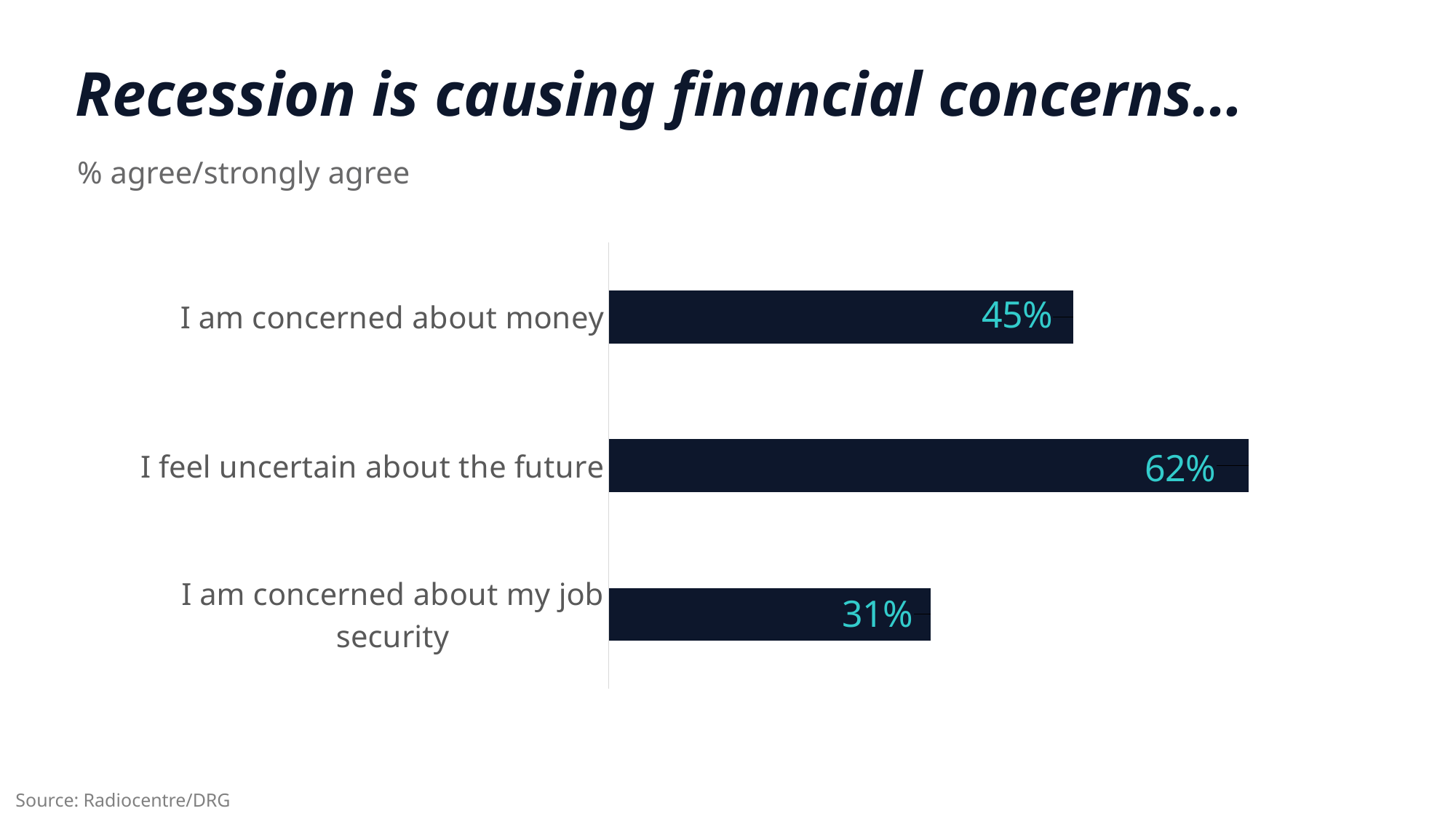
What is the difference in percentage points between "I feel uncertain about the future" and "I am concerned about money"? 17 What is the source cited for the chart data? Radiocentre/DRG Which statement has the highest percentage of agreement? I feel uncertain about the future What percentage agree or strongly agree with "I feel uncertain about the future"? 62% What type of chart is shown on the slide? Bar chart What is the difference in percentage points between "I am concerned about money" and "I am concerned about my job security"? 14 Which has a higher percentage: "I am concerned about money" or "I am concerned about my job security"? I am concerned about money Which statement has the lowest percentage of agreement? I am concerned about my job security How many statements are shown in the chart? 3 What percentage agree or strongly agree with "I am concerned about my job security"? 31% What percentage agree or strongly agree with "I am concerned about money"? 45% What is the title of the slide? Recession is causing financial concerns...